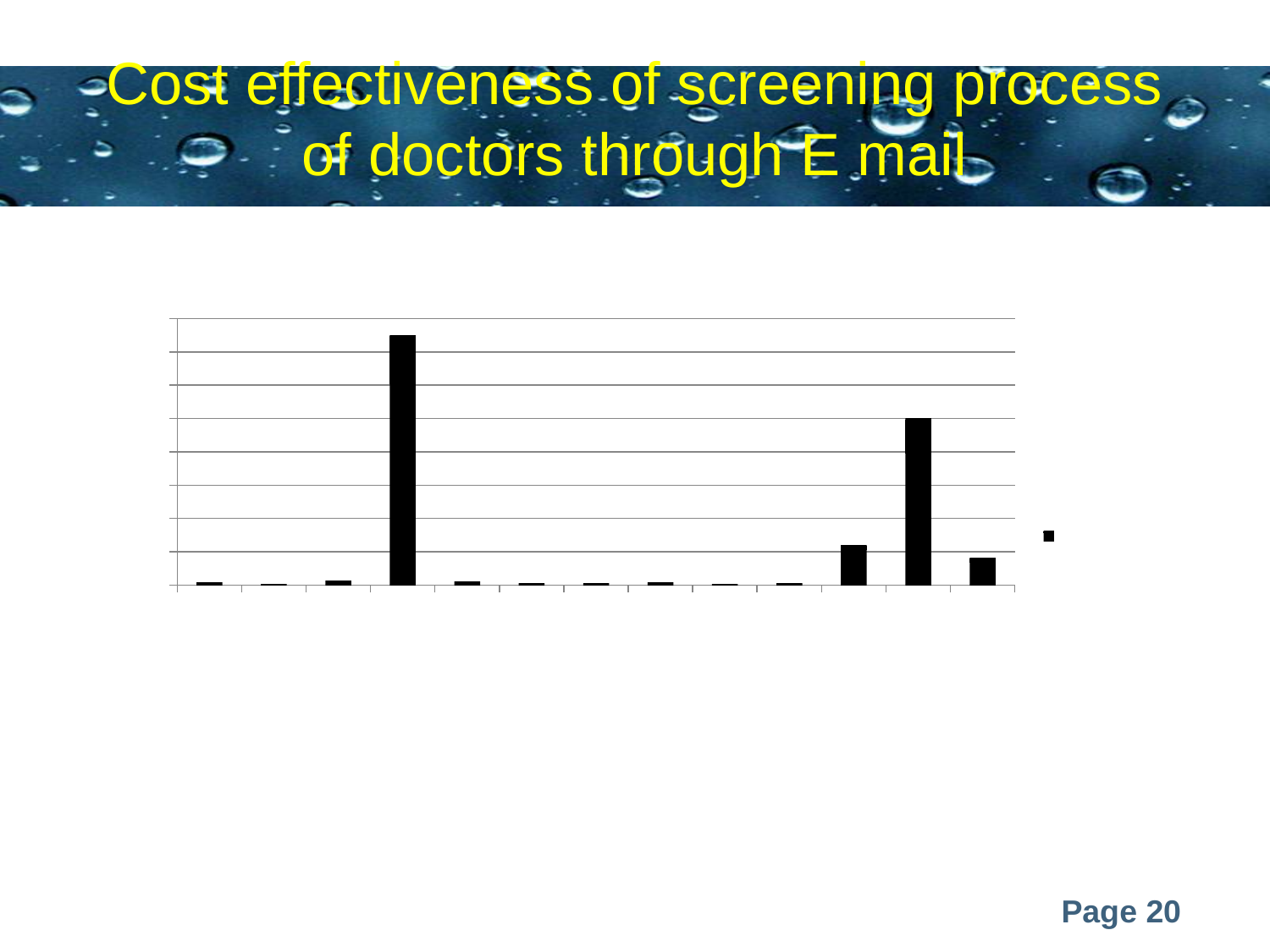
What is the title of the slide containing the chart? Cost effectiveness of screening process of doctors through E mail How many series does the chart's legend show? 1 Which is taller: the fourth bar from the left or the twelfth bar from the left? the fourth bar How many bars are plotted in the chart? 13 Which is taller: the eleventh bar from the left or the thirteenth bar from the left? the eleventh bar Which bar is the tallest in the chart, counting from the left? the fourth bar What kind of chart is shown on the slide? bar chart What colour are the bars in the chart? black